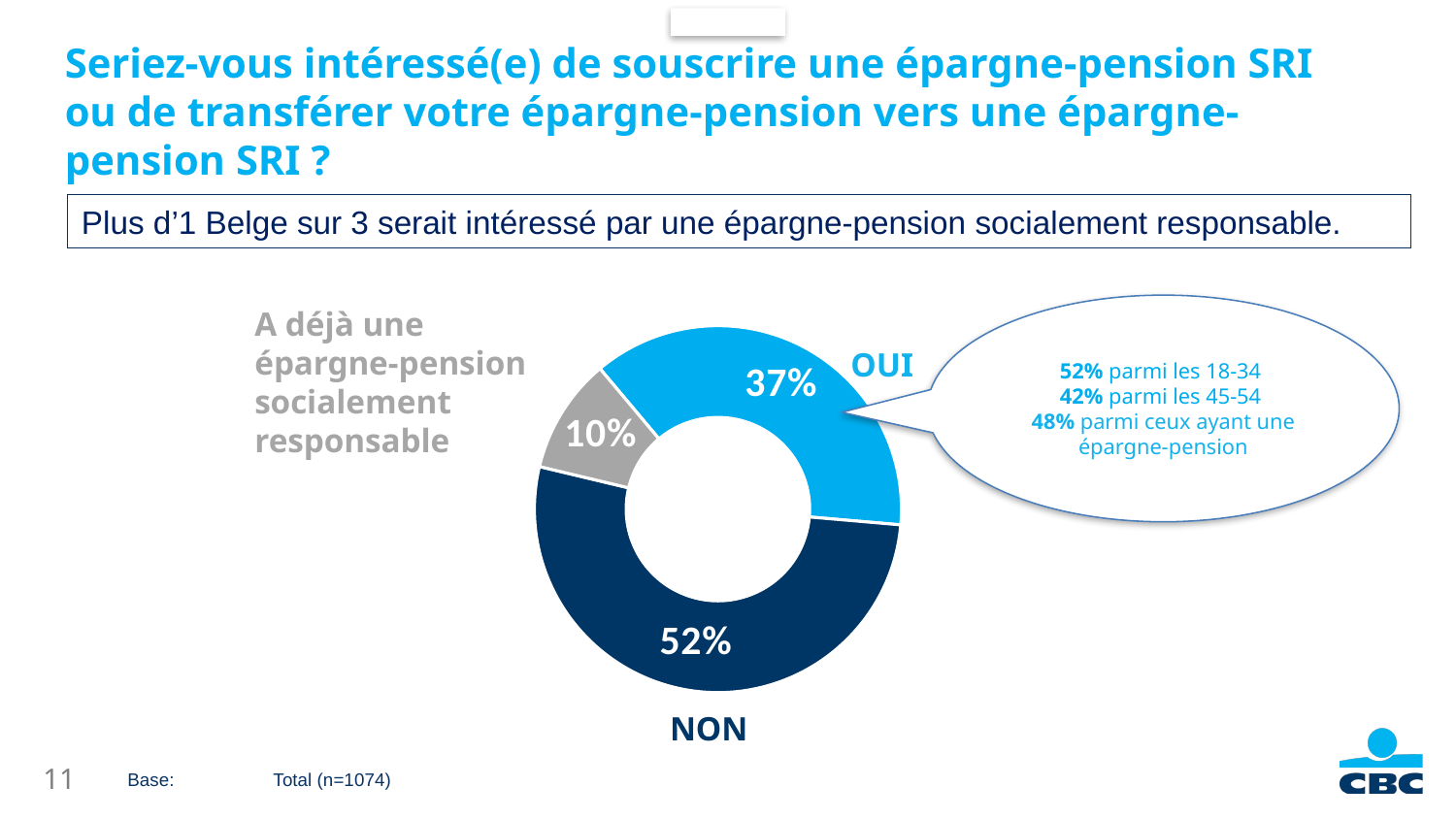
What percentage of respondents already have a socially responsible pension savings plan ("A déjà une épargne-pension socialement responsable")? 10% What type of chart is shown on the slide? Pie chart (donut) Which response has the largest share of the chart? NON How many slices does the chart have? 3 Which slice of the chart is the smallest? A déjà une épargne-pension socialement responsable What percentage of respondents answered NON? 52% What percentage of respondents answered OUI? 37% According to the callout, what percentage of 18-34 year olds are interested? 52% What is the difference in percentage points between NON and OUI? 15 Which is larger, the share for OUI or the share for NON? NON According to the callout, what percentage of those who already have a pension savings plan are interested? 48% What is the sample size (n) given in the base note? 1074